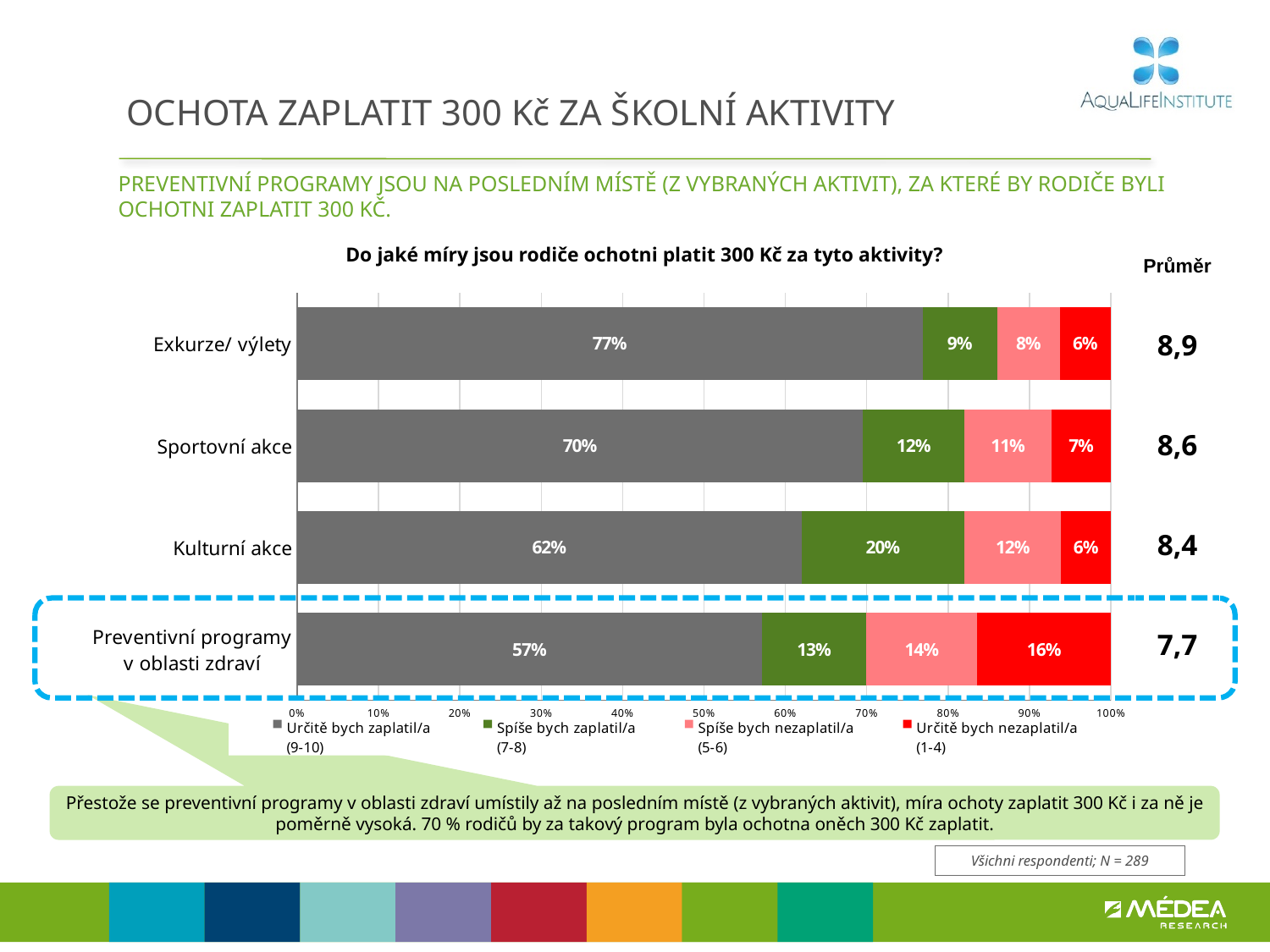
How many categories (activities) are shown on the chart? 4 What is the Průměr (average) shown for Sportovní akce? 8,6 Which is larger: the "Spíše bych nezaplatil/a (5-6)" value for Sportovní akce or for Preventivní programy v oblasti zdraví? Preventivní programy v oblasti zdraví How many series does the legend list? 4 What is the difference between the "Určitě bych zaplatil/a (9-10)" values for Sportovní akce and Preventivní programy v oblasti zdraví? 13 percentage points What percentage of parents answered "Určitě bych zaplatil/a (9-10)" for Exkurze/ výlety? 77% Which category has the highest share of "Určitě bych zaplatil/a (9-10)"? Exkurze/ výlety What type of chart is shown on the slide? Stacked bar chart What is the "Spíše bych zaplatil/a (7-8)" value for Kulturní akce? 20% What is the "Určitě bych nezaplatil/a (1-4)" value for Preventivní programy v oblasti zdraví? 16% Which category has the lowest Průměr value? Preventivní programy v oblasti zdraví What is the title of the chart? Do jaké míry jsou rodiče ochotni platit 300 Kč za tyto aktivity?